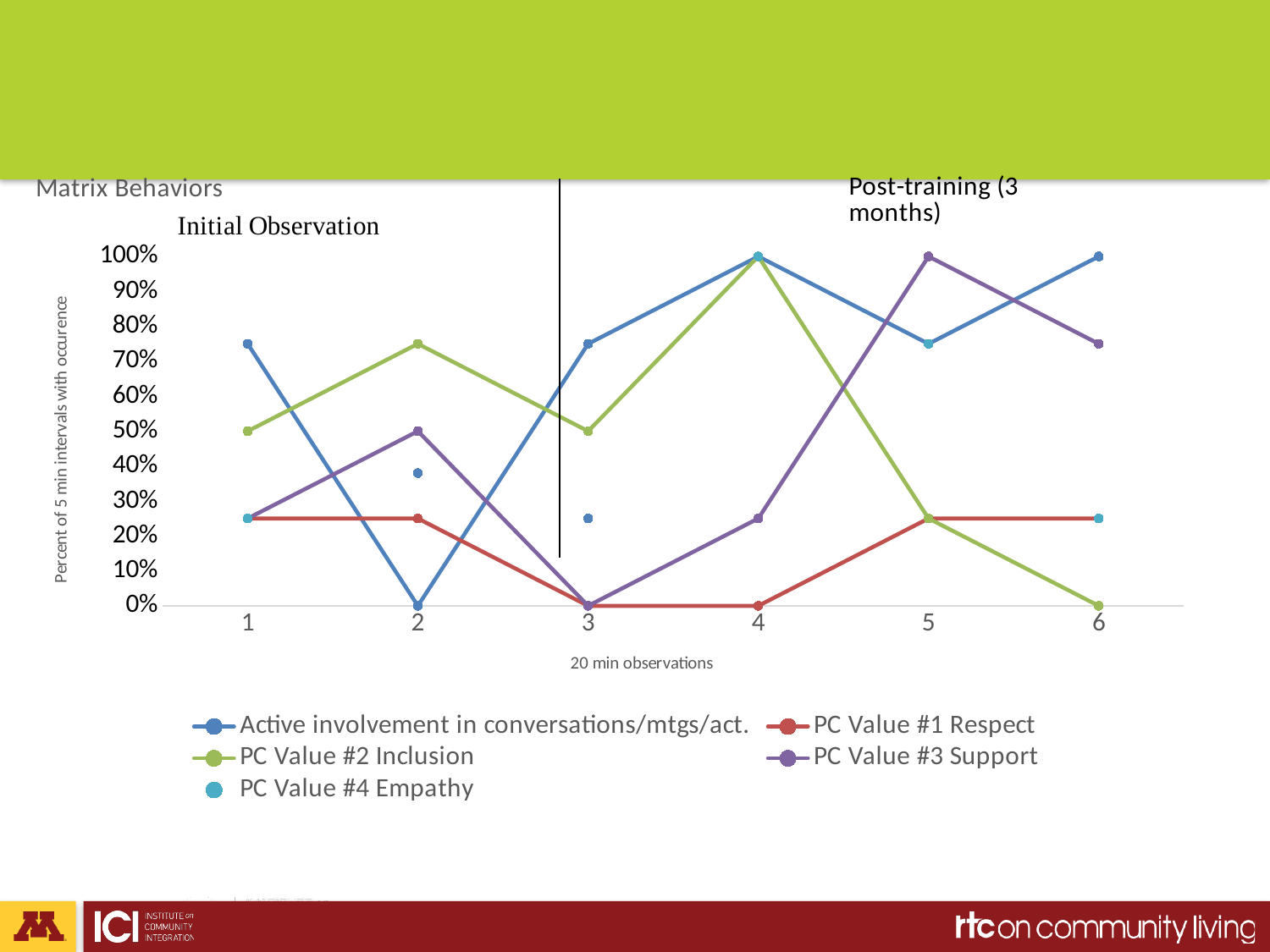
What is the value for Active involvement in conversations/mtgs/act. at observation 2? 0% At which observation is PC Value #2 Inclusion lowest? 6 What is the difference between PC Value #2 Inclusion at observation 4 and at observation 6? 100% At observation 2, which is larger: PC Value #2 Inclusion or Active involvement in conversations/mtgs/act.? PC Value #2 Inclusion What is the title of the y axis? Percent of 5 min intervals with occurence What kind of chart is shown on the slide? line chart What is the value for PC Value #2 Inclusion at observation 4? 100% What is the value for PC Value #3 Support at observation 5? 100% Is the value for Active involvement in conversations/mtgs/act. at observation 1 greater or less than 70%? greater What is the value for PC Value #2 Inclusion at observation 1? 50% How many series does the legend list? 5 How many observation points are shown along the x axis? 6